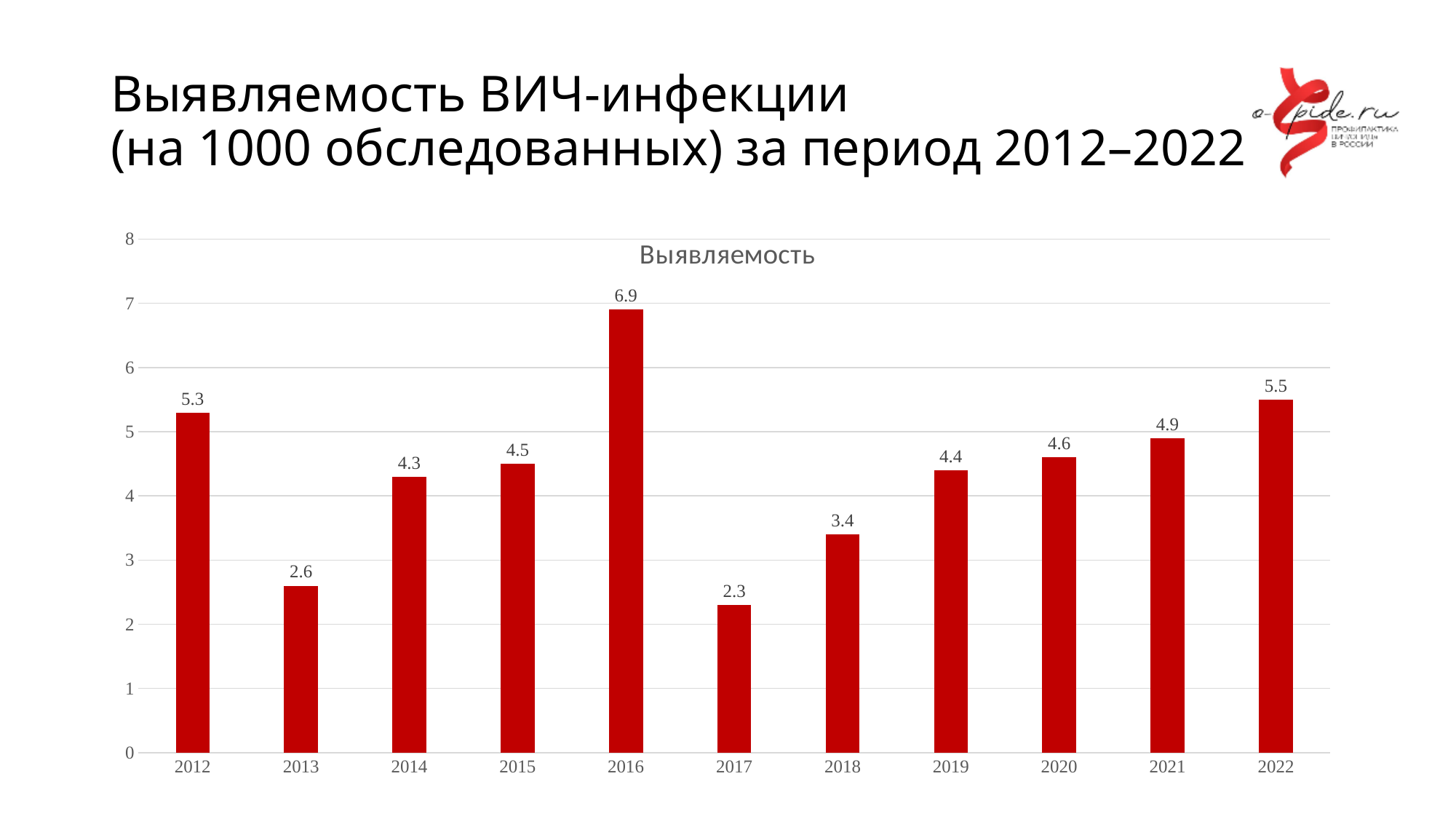
What is the difference between the values for 2016 and 2017? 4.6 What kind of chart is shown on the slide? bar chart Do the values rise or fall from 2017 to 2022? rise Which is larger, the value for 2014 or the value for 2018? 2014 What is the value for 2022? 5.5 How many years are shown on the x axis? 11 Which year has the lowest value? 2017 Is the value for 2019 greater or less than 4? greater What is the value for 2016? 6.9 What is the difference between the values for 2022 and 2012? 0.2 Which year has the highest value? 2016 What is the value for 2013? 2.6